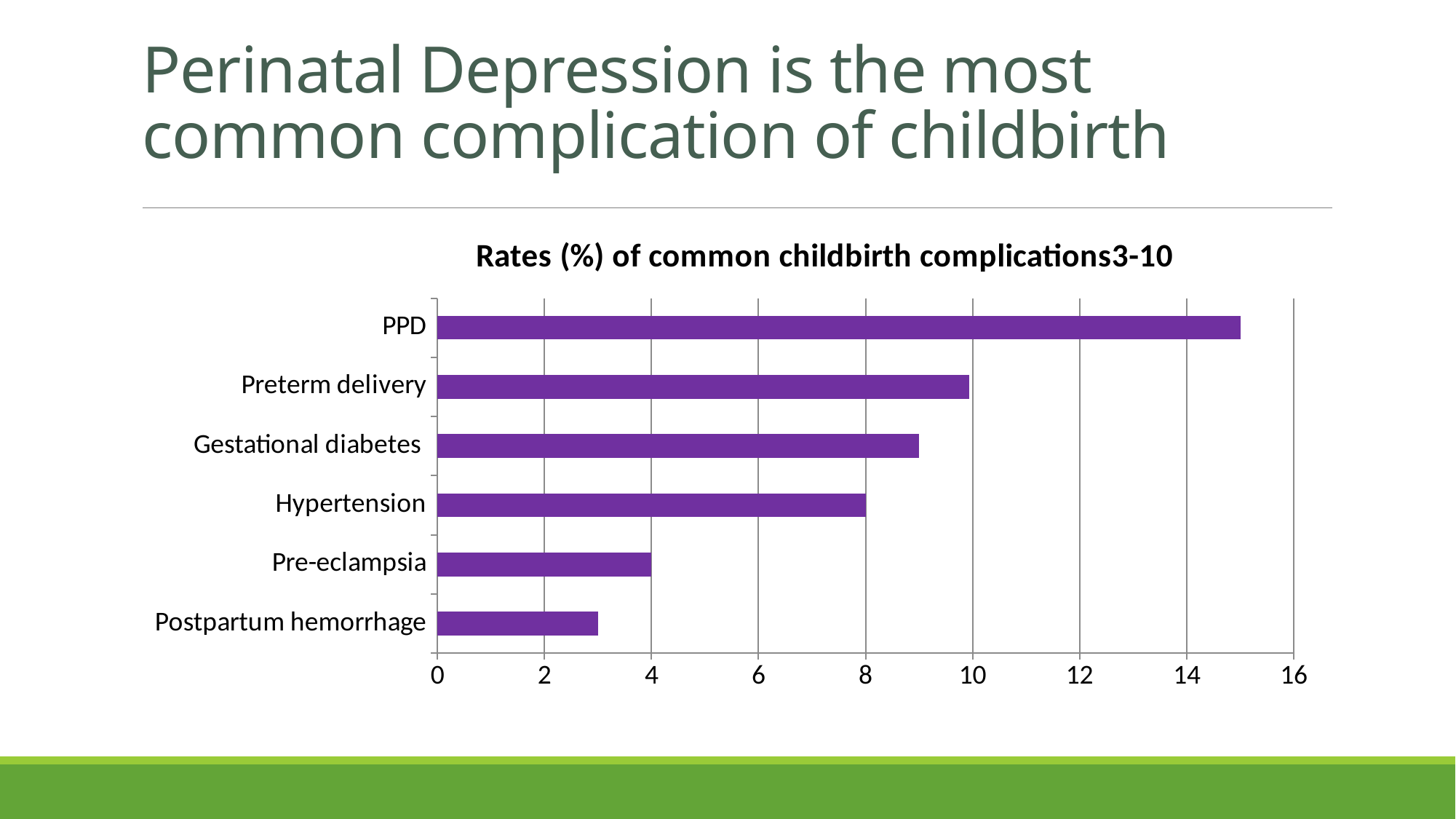
What is the rate (%) for Hypertension? 8 What is the rate (%) for Pre-eclampsia? 4 Which complication has the highest rate in the chart? PPD What colour are the bars in the chart? purple What is the title of the chart? Rates (%) of common childbirth complications3-10 Which has a higher rate, Preterm delivery or Gestational diabetes? Preterm delivery Is the value for Postpartum hemorrhage greater or less than 4? less What type of chart is shown on the slide? bar chart Which complication has the lowest rate in the chart? Postpartum hemorrhage How many complication categories are shown in the chart? 6 What is the difference between the rates for Hypertension and Pre-eclampsia? 4 Is the value for PPD greater or less than 14? greater